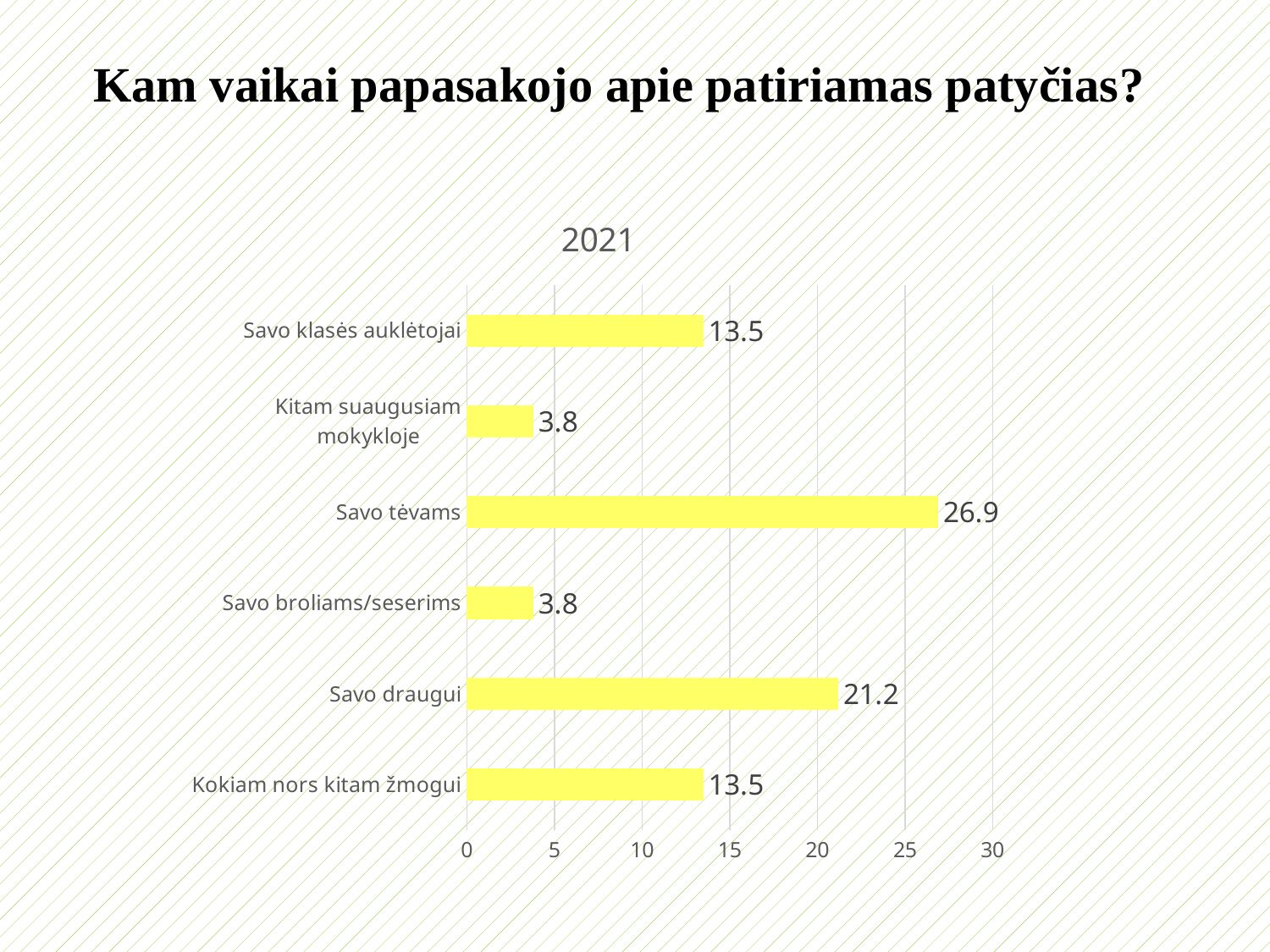
What is the title of the chart? 2021 What is the difference between the values for Savo tėvams and Savo draugui? 5.7 What is the value for Kitam suaugusiam mokykloje? 3.8 What kind of chart is shown on the slide? Bar chart Is the value for Savo tėvams greater or less than 25? greater Which is larger, the value for Savo draugui or the value for Kokiam nors kitam žmogui? Savo draugui What is the value for Savo tėvams? 26.9 What is the value for Savo klasės auklėtojai? 13.5 Which category has the highest value? Savo tėvams How many categories are shown in the chart? 6 What is the value for Savo draugui? 21.2 What is the difference between the values for Savo klasės auklėtojai and Savo broliams/seserims? 9.7